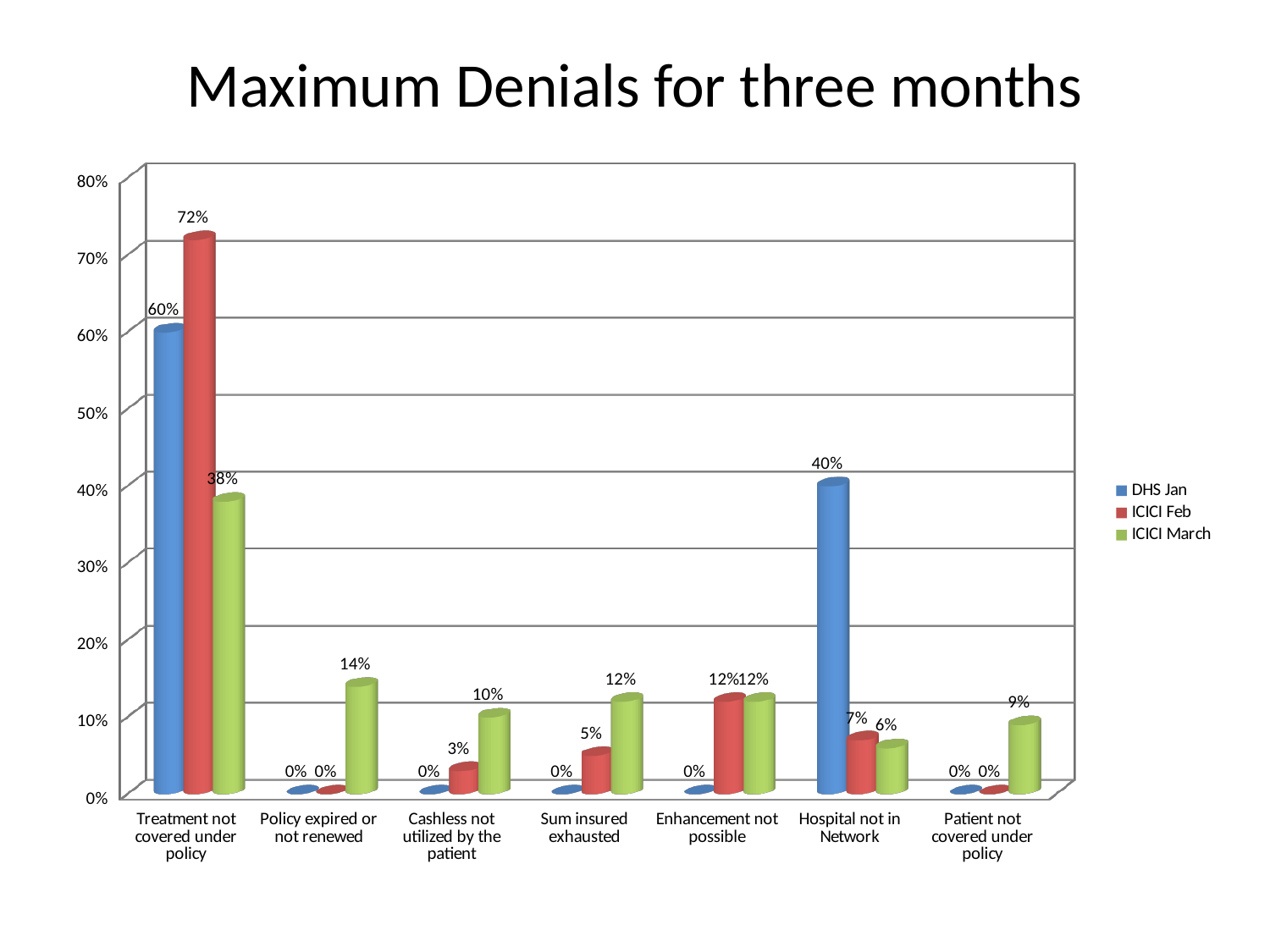
What kind of chart is shown on the slide? Bar chart Which is larger for Hospital not in Network: the ICICI Feb value or the ICICI March value? ICICI Feb Which category has the lowest ICICI March value? Hospital not in Network What is the difference between the ICICI Feb and DHS Jan values for Treatment not covered under policy? 12% How many categories are shown on the x axis? 7 What is the ICICI Feb value for Treatment not covered under policy? 72% Which category has the highest ICICI March value? Treatment not covered under policy What is the ICICI March value for Policy expired or not renewed? 14% What is the DHS Jan value for Hospital not in Network? 40% What is the ICICI Feb value for Sum insured exhausted? 5% What is the title of the chart? Maximum Denials for three months How many series does the legend list? 3